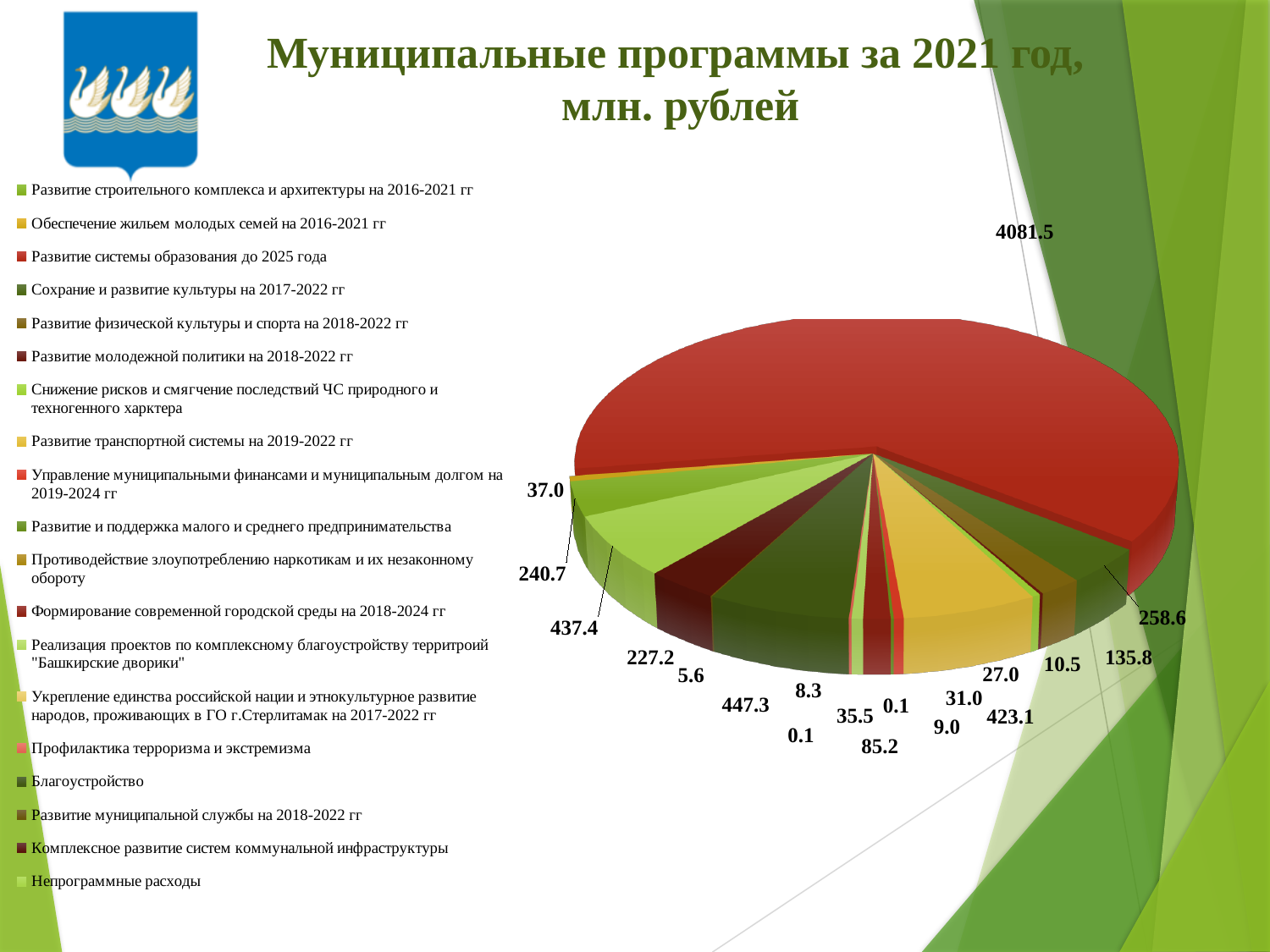
Does the largest slice of the pie chart make up more than half of the pie? yes Which is larger, the slice labelled 35.5 or the slice labelled 31.0? 35.5 What is the title of the chart on the slide? Муниципальные программы за 2021 год, млн. рублей How many entries does the legend of the pie chart list? 19 How many slices of the pie chart are labelled 0.1? 2 What is the smallest value labelled on the pie chart? 0.1 What kind of chart is shown on the slide? pie chart What is the largest value labelled on the pie chart? 4081.5 What is the difference between the slices labelled 447.3 and 437.4? 9.9 Which is larger, the slice labelled 258.6 or the slice labelled 240.7? 258.6 What is the difference between the largest slice (4081.5) and the slice labelled 447.3? 3634.2 What is the second largest value labelled on the pie chart? 447.3